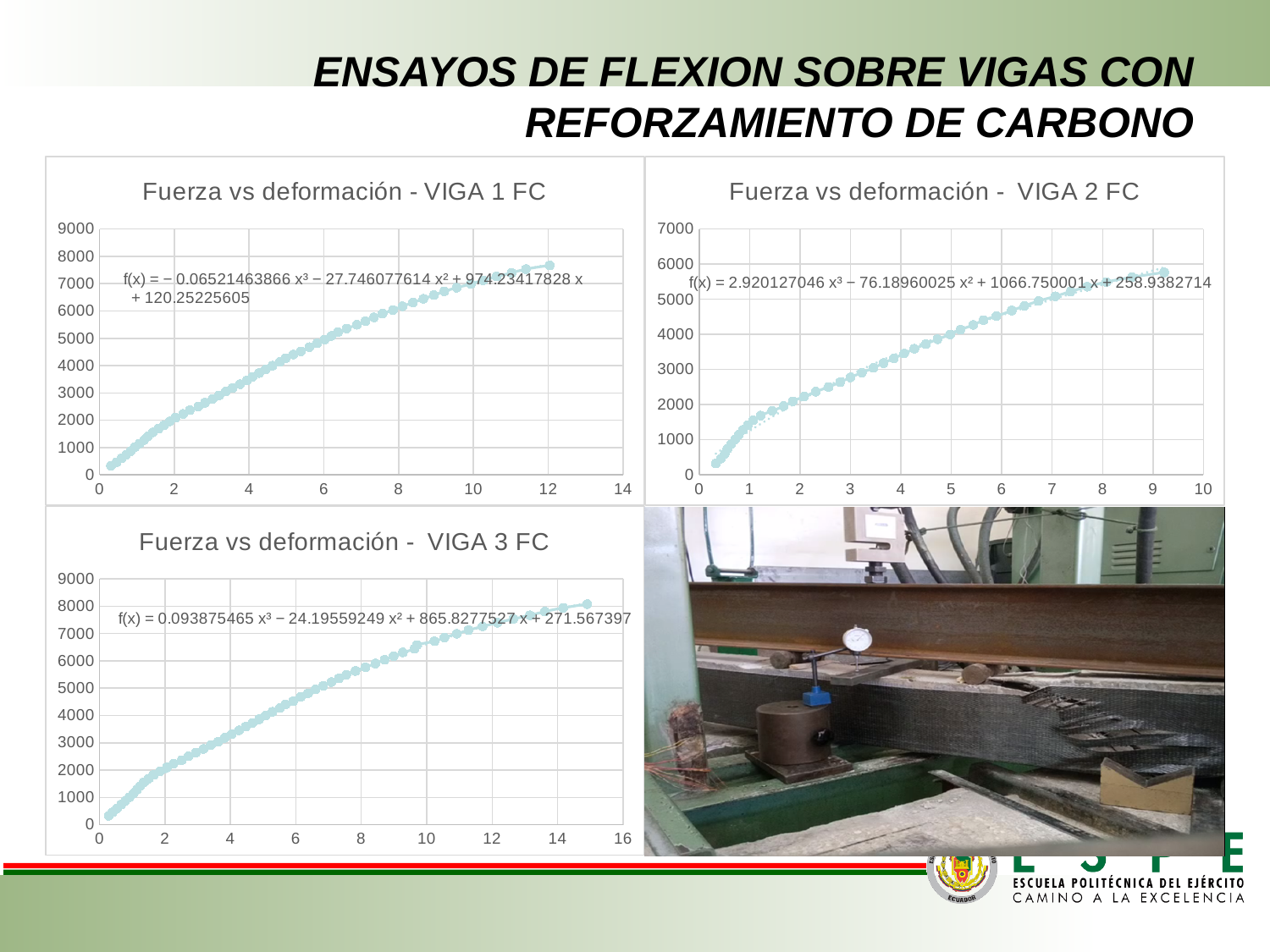
In the chart "Fuerza vs deformación - VIGA 3 FC", do the values rise or fall along the x axis? rise What kind of chart is "Fuerza vs deformación - VIGA 1 FC"? scatter chart In the chart "Fuerza vs deformación - VIGA 2 FC", is the highest plotted value greater or less than 6000? less In the chart "Fuerza vs deformación - VIGA 2 FC", do the values rise or fall as the x axis increases? rise In the chart "Fuerza vs deformación - VIGA 2 FC", is the highest plotted value greater or less than 5000? greater In the chart "Fuerza vs deformación - VIGA 1 FC", is the highest plotted value greater or less than 8000? less How many charts are shown on the slide? 3 What is the highest tick shown on the y axis of the chart "Fuerza vs deformación - VIGA 2 FC"? 7000